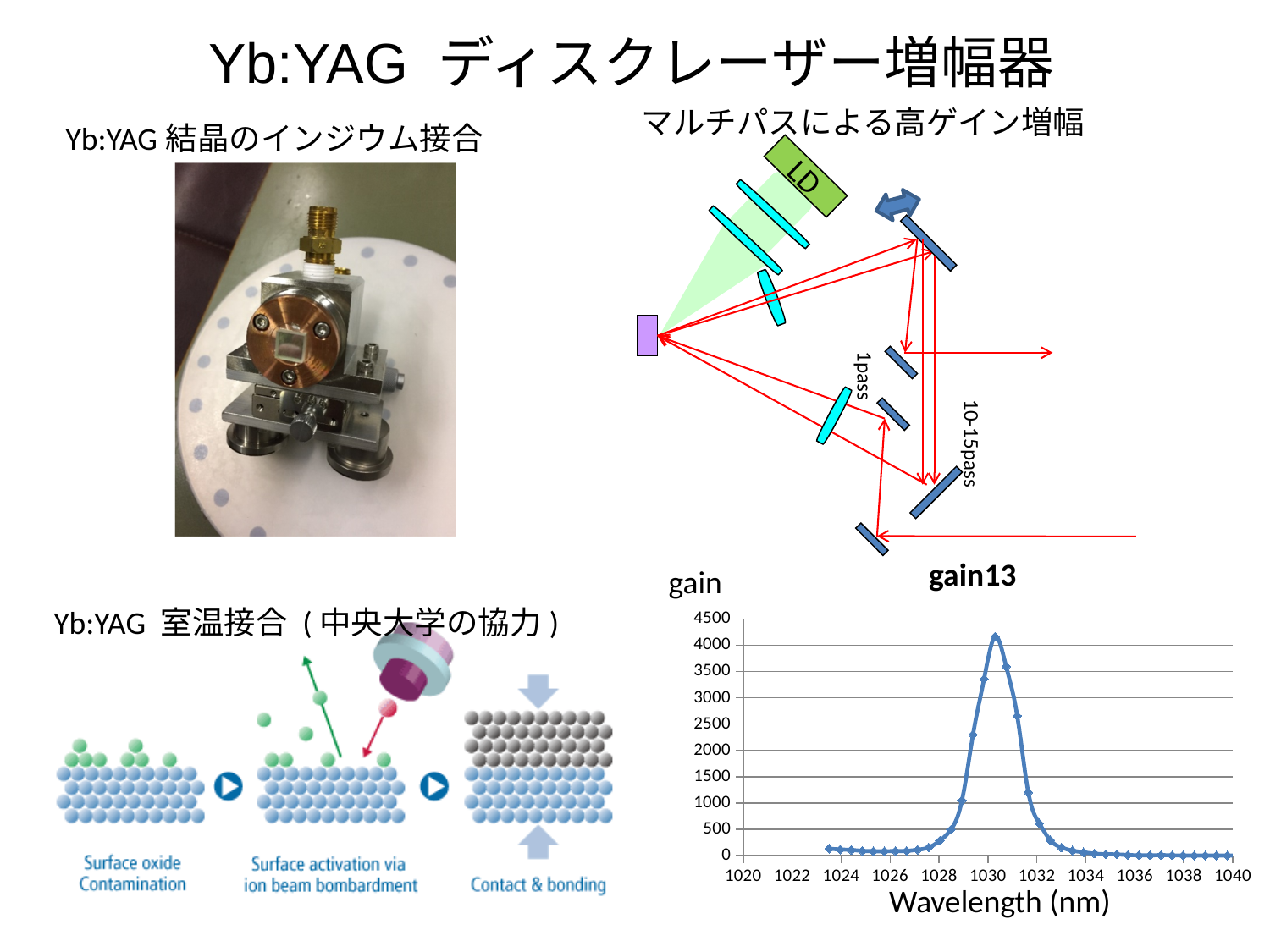
In the gain chart, is the peak gain value greater or less than 4000? greater What quantity is plotted on the y-axis of the chart at the bottom right? gain In the gain chart, which is larger, the gain at 1030 nm or the gain at 1034 nm? 1030 nm What is the x-axis title of the gain chart? Wavelength (nm) What kind of chart is the gain versus wavelength chart at the bottom right of the slide? line chart In the gain chart, is the gain at 1036 nm greater or less than 500? less In the gain chart, does the gain rise or fall as the wavelength increases from 1031 nm to 1036 nm? fall In the gain chart, is the gain at 1024 nm greater or less than 1000? less In the gain chart, does the gain rise or fall as the wavelength increases from 1026 nm to 1030 nm? rise What is the highest value shown on the y-axis of the gain chart? 4500